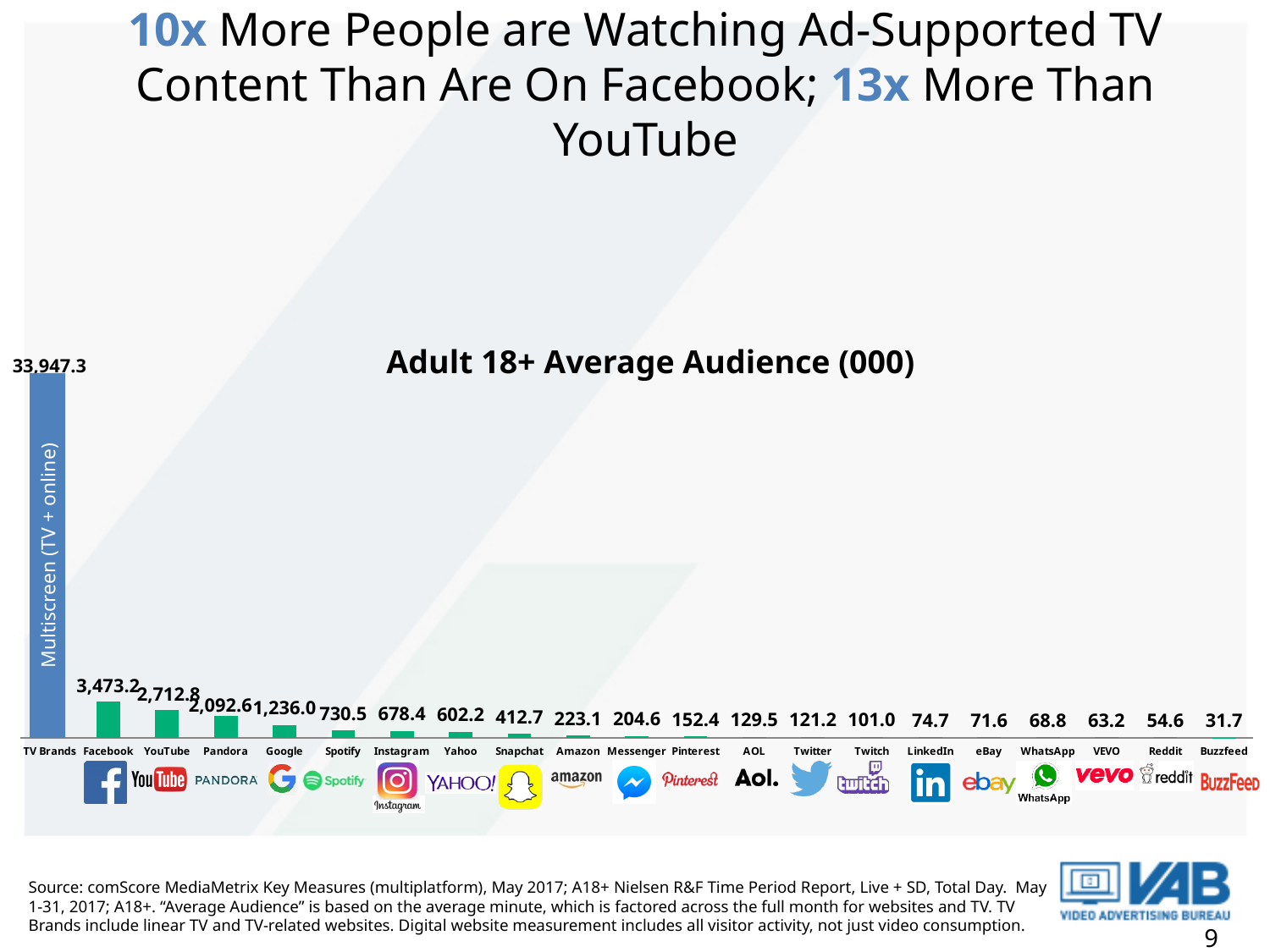
What is the Adult 18+ average audience (000) for Snapchat? 412.7 What kind of chart is shown on the slide? Bar chart How many categories are shown in the chart? 21 What is the Adult 18+ average audience (000) for TV Brands? 33,947.3 What is the Adult 18+ average audience (000) for Facebook? 3,473.2 Do the values rise or fall moving from left to right along the x axis? Fall Which category has the highest Adult 18+ average audience? TV Brands Which category has the lowest Adult 18+ average audience? Buzzfeed Which has a larger Adult 18+ average audience, Pandora or Google? Pandora What is the difference between the Facebook and YouTube average audience values (000)? 760.4 What is the difference between the Twitter and Twitch average audience values (000)? 20.2 What is the Adult 18+ average audience (000) for Twitch? 101.0